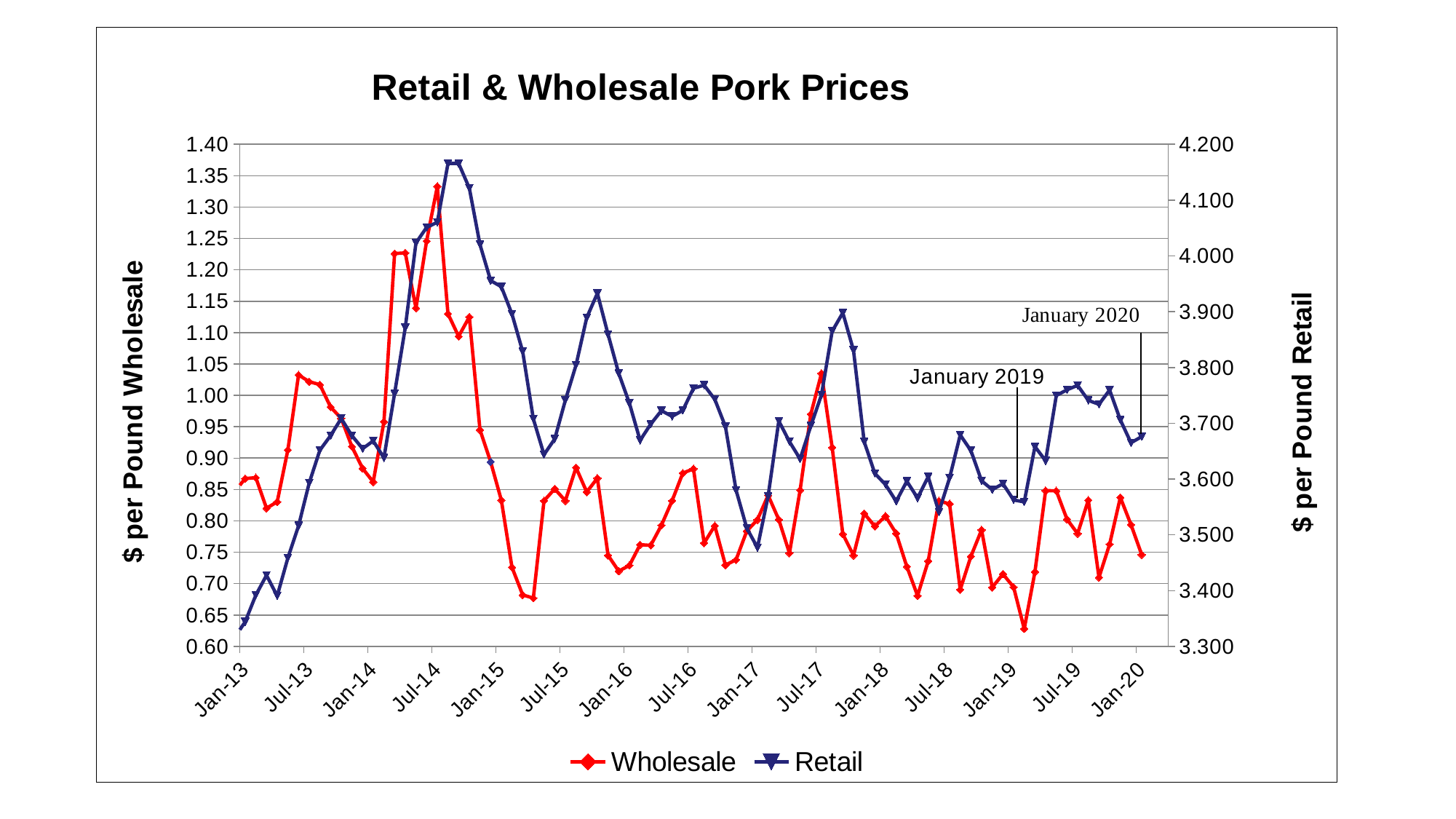
Is the Wholesale value at Jan-20 greater or less than 0.80? less Is the Wholesale value higher at Jan-13 or at Jan-20? Jan-13 Is the Retail value at Jan-13 greater or less than 3.400? less How many series does the legend list? 2 Which series is plotted against the right-hand axis labelled "$ per Pound Retail"? Retail Is the Retail value at Jan-20 greater or less than 3.600? greater What kind of chart is shown on the slide? line chart In which year does the Retail series reach its highest value? 2014 What is the title of the chart? Retail & Wholesale Pork Prices